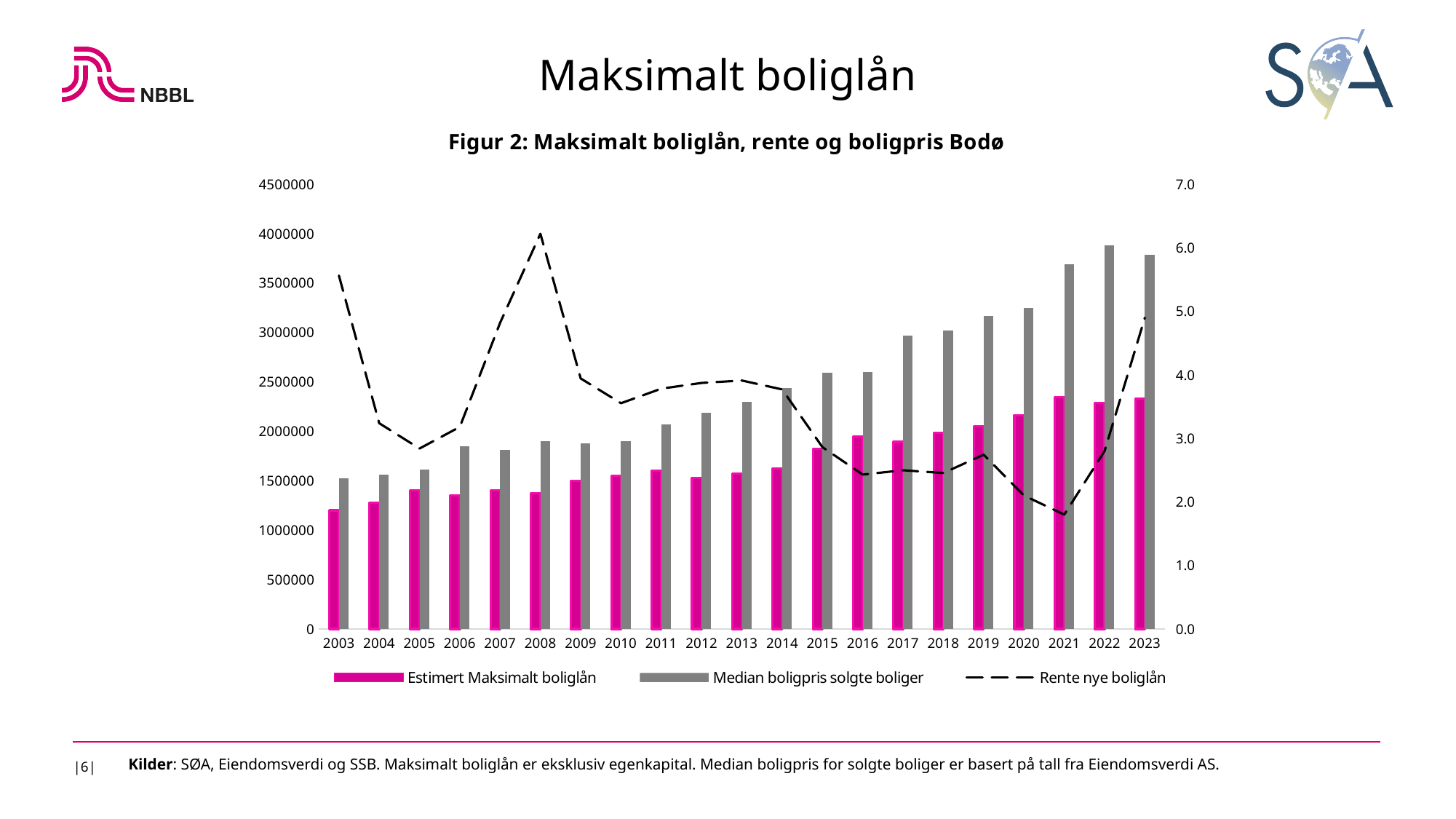
How many years are shown on the x axis of the chart? 21 Is the value of Median boligpris solgte boliger in 2022 greater or less than 3500000? greater In which year is Estimert Maksimalt boliglån lowest? 2003 In which year is Median boligpris solgte boliger highest? 2022 Is the value of Estimert Maksimalt boliglån in 2003 greater or less than 1500000? less What is the title of the chart on the slide? Figur 2: Maksimalt boliglån, rente og boligpris Bodø How many series does the chart's legend list? 3 In which year is Rente nye boliglån lowest? 2021 Which is larger in 2008: Median boligpris solgte boliger or Estimert Maksimalt boliglån? Median boligpris solgte boliger In which year is Rente nye boliglån highest? 2008 Is the value of Rente nye boliglån in 2008 greater or less than 5.0? greater What kind of chart is shown on the slide? Combined bar and line chart